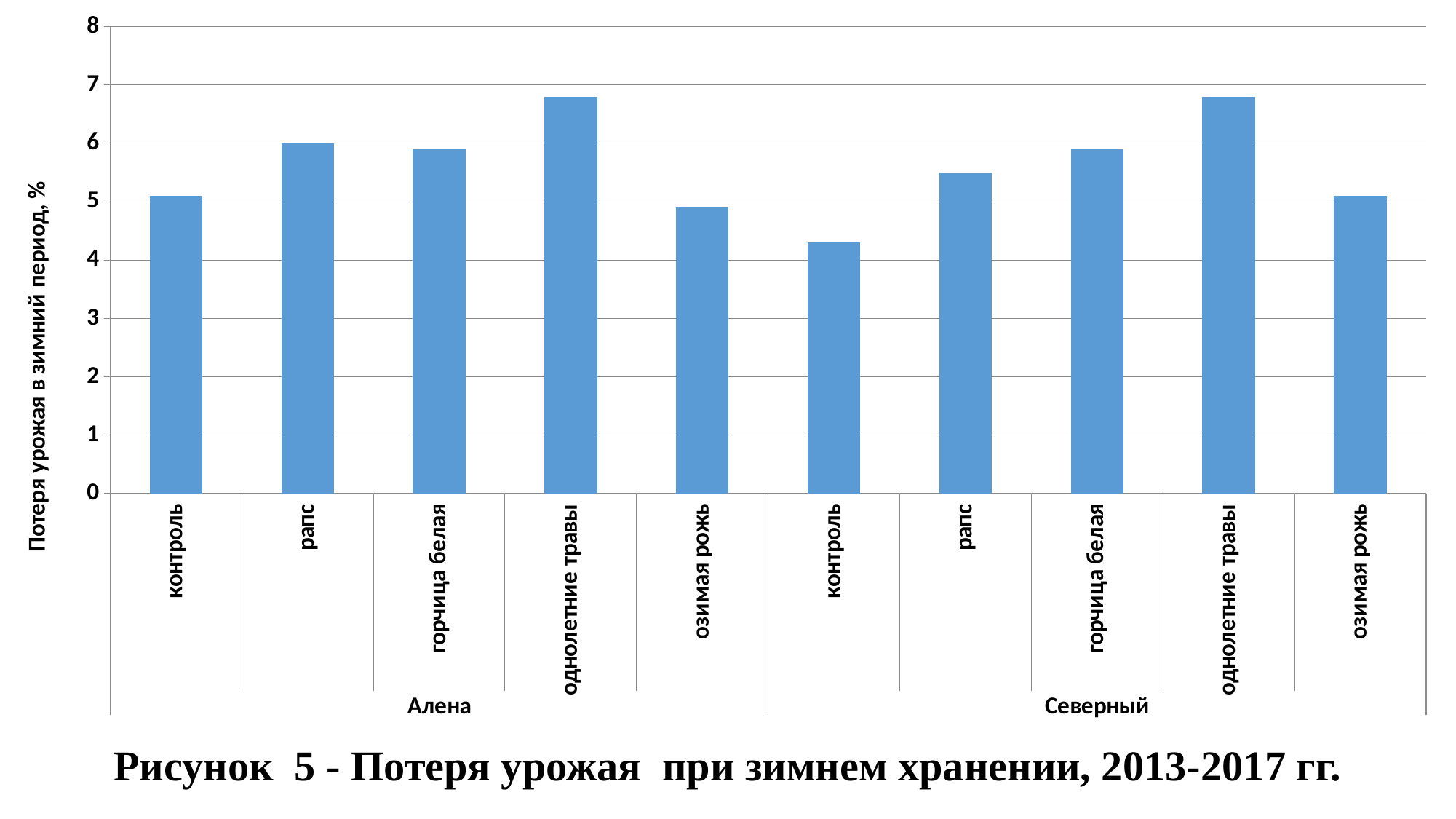
What is the title of the vertical axis? Потеря урожая в зимний период, % Within the Северный group, which category has the highest bar? однолетние травы What kind of chart is shown on the slide? bar chart Is the value for контроль in the Северный group greater or less than 4? greater What is the value for рапс in the Алена group? 6 Is the value for однолетние травы in the Алена group greater or less than 7? less How many bars are plotted in the chart? 10 Which is larger: контроль in the Алена group or контроль in the Северный group? контроль in the Алена group Which bar is the lowest in the whole chart? контроль (Северный) What are the two group labels shown along the x axis? Алена and Северный